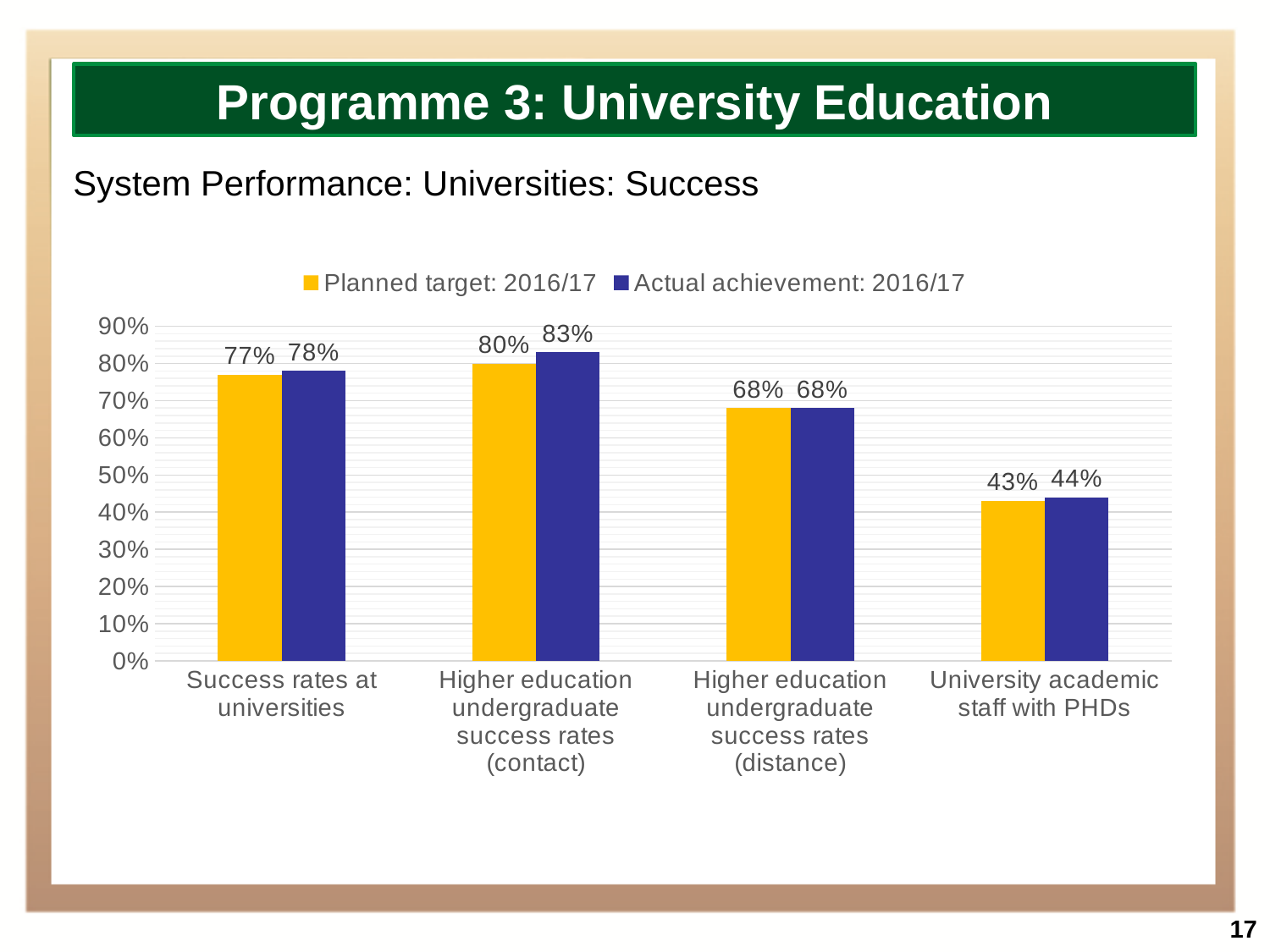
What kind of chart is shown on the slide? Bar chart What is the difference between the actual achievement and the planned target for Higher education undergraduate success rates (contact)? 3% Is the actual achievement for University academic staff with PHDs greater or less than 50%? less What is the planned target for 2016/17 for Success rates at universities? 77% Which category has the lowest planned target for 2016/17? University academic staff with PHDs Is the planned target for Higher education undergraduate success rates (distance) larger than the actual achievement for the same category? No, they are equal (68%) What is the actual achievement for 2016/17 for Higher education undergraduate success rates (contact)? 83% How many categories are shown on the x axis? 4 How many series does the legend list? 2 Which category has the highest actual achievement for 2016/17? Higher education undergraduate success rates (contact) What is the actual achievement for 2016/17 for University academic staff with PHDs? 44% Which colour represents the Planned target: 2016/17 series? Yellow